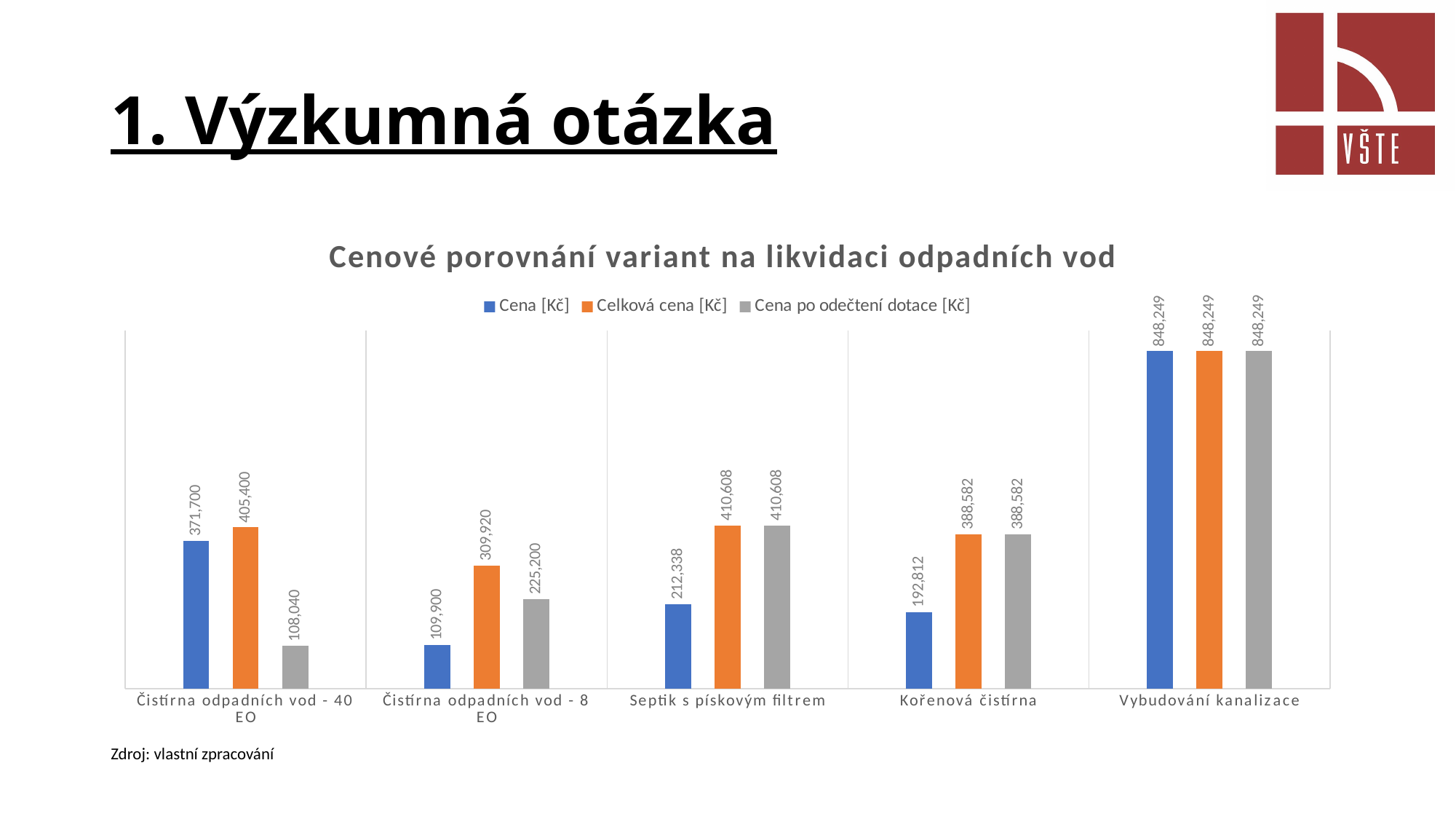
What is the Cena [Kč] value for Kořenová čistírna? 192,812 Which category has the highest Celková cena [Kč]? Vybudování kanalizace What is the difference between the Celková cena [Kč] and the Cena po odečtení dotace [Kč] for Čistírna odpadních vod - 40 EO? 297,360 What is the Cena [Kč] value for Čistírna odpadních vod - 40 EO? 371,700 What is the Celková cena [Kč] value for Čistírna odpadních vod - 8 EO? 309,920 What kind of chart is shown on the slide? Bar chart Which category has the lowest Cena po odečtení dotace [Kč]? Čistírna odpadních vod - 40 EO What is the title of the chart? Cenové porovnání variant na likvidaci odpadních vod How many series does the legend list? 3 How many categories are shown on the x axis? 5 Which is larger: the Cena [Kč] for Septik s pískovým filtrem or the Cena [Kč] for Kořenová čistírna? Septik s pískovým filtrem What is the Cena po odečtení dotace [Kč] value for Septik s pískovým filtrem? 410,608